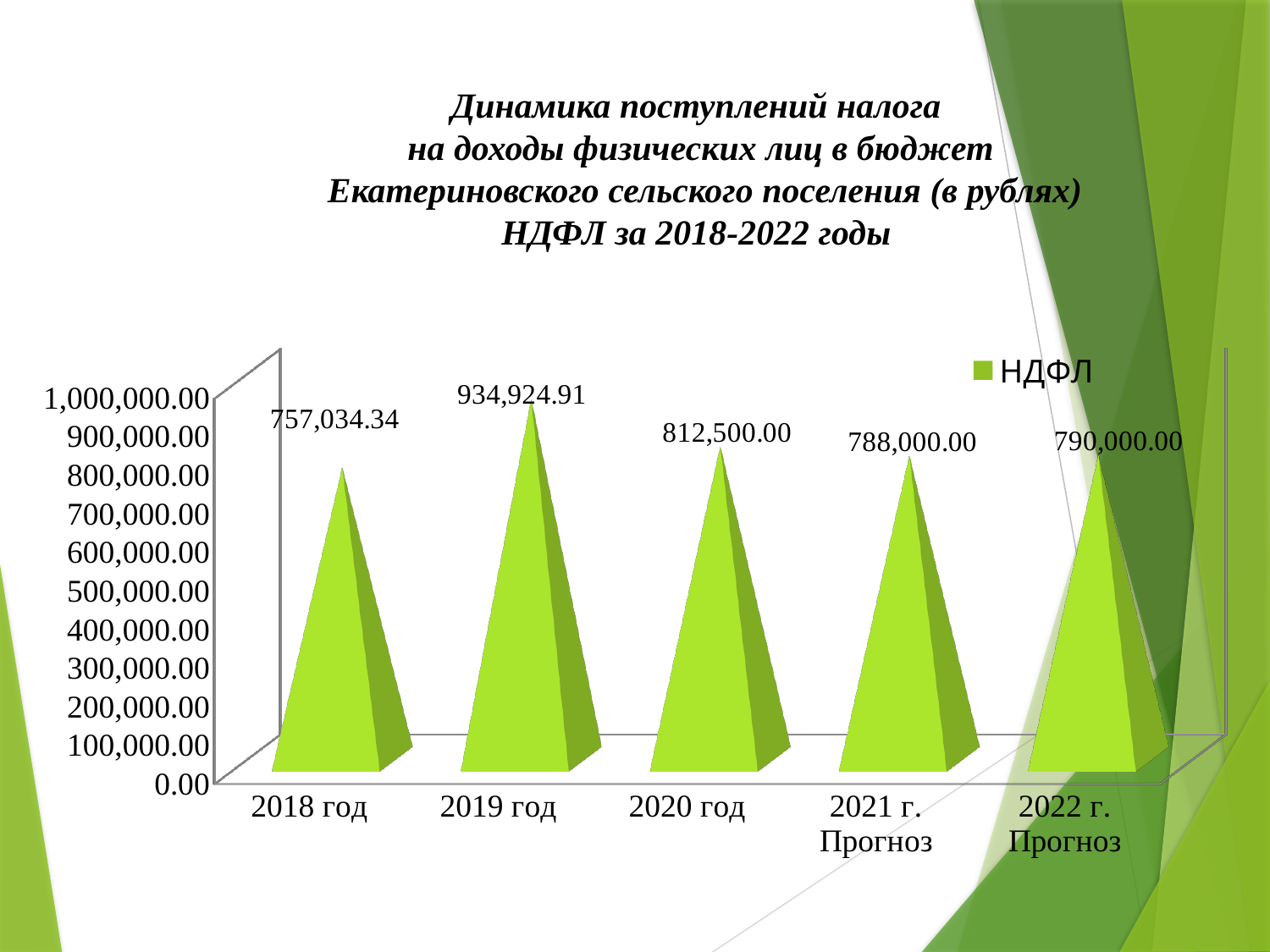
How many categories are shown on the x axis? 5 What kind of chart is shown on the slide? bar chart What is the value for 2021 г. Прогноз? 788,000.00 Which year has the lowest value? 2018 год Which is larger, the value for 2020 год or the value for 2018 год? 2020 год How many series does the legend list? 1 What is the difference between the values for 2020 год and 2021 г. Прогноз? 24,500.00 What is the value for 2018 год? 757,034.34 What is the difference between the values for 2019 год and 2018 год? 177,890.57 What is the value for 2022 г. Прогноз? 790,000.00 Which year has the highest value? 2019 год What is the value for 2019 год? 934,924.91